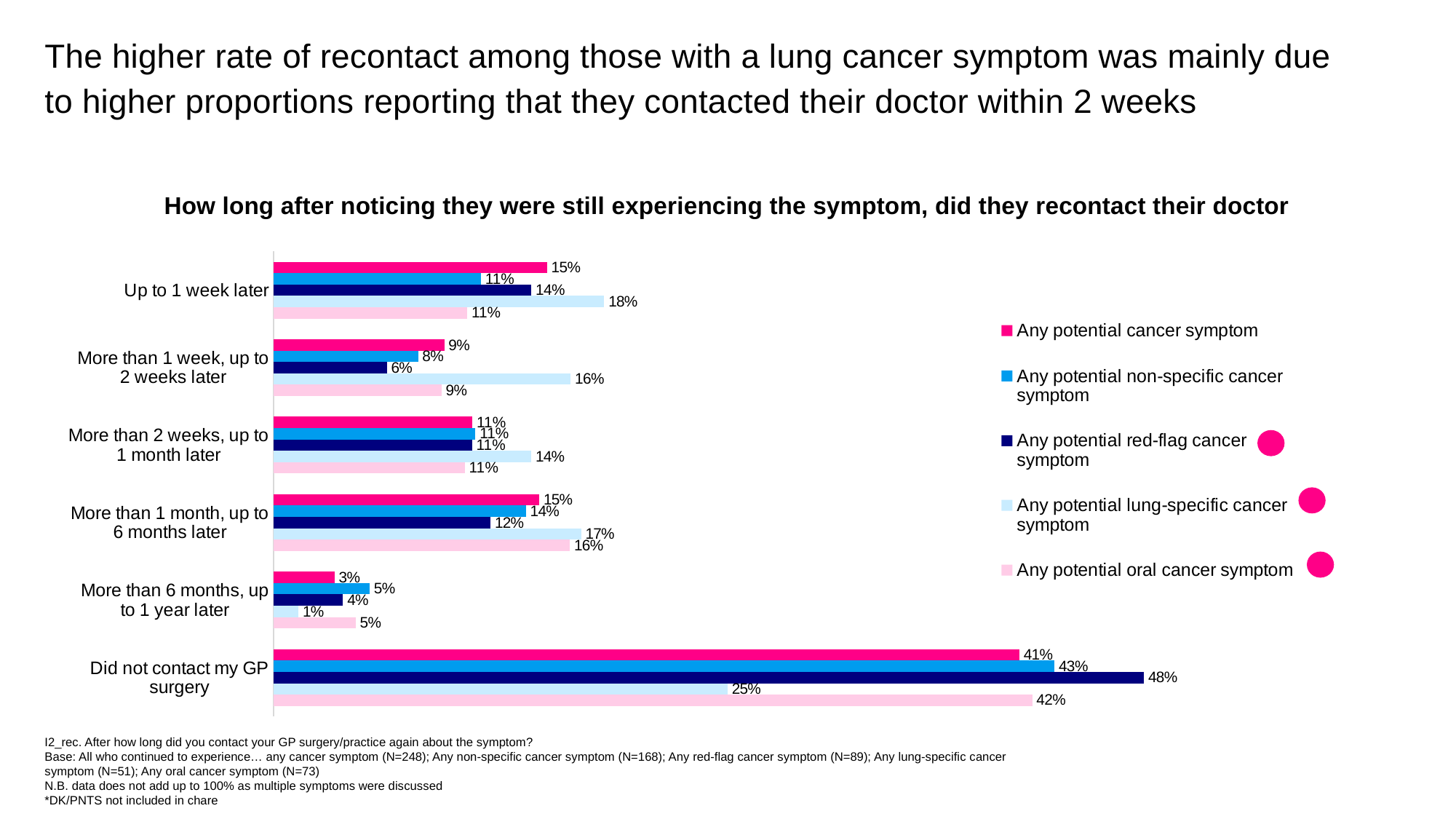
How many categories are shown on the chart? 6 In the 'More than 1 month, up to 6 months later' category, which is larger: the value for 'Any potential oral cancer symptom' or 'Any potential red-flag cancer symptom'? Any potential oral cancer symptom What is the difference between the 'Any potential red-flag cancer symptom' and 'Any potential lung-specific cancer symptom' values in the 'Did not contact my GP surgery' category? 23% What is the value for 'Any potential cancer symptom' in the 'More than 6 months, up to 1 year later' category? 3% How many series does the legend list? 5 Which series has the lowest value in the 'Did not contact my GP surgery' category? Any potential lung-specific cancer symptom What is the value for 'Any potential red-flag cancer symptom' in the 'Did not contact my GP surgery' category? 48% What kind of chart is shown on the slide? Bar chart What is the value for 'Any potential lung-specific cancer symptom' in the 'Up to 1 week later' category? 18% What is the value for 'Any potential non-specific cancer symptom' in the 'More than 1 week, up to 2 weeks later' category? 8% Which series has the highest value in the 'More than 1 week, up to 2 weeks later' category? Any potential lung-specific cancer symptom What is the title of the chart? How long after noticing they were still experiencing the symptom, did they recontact their doctor